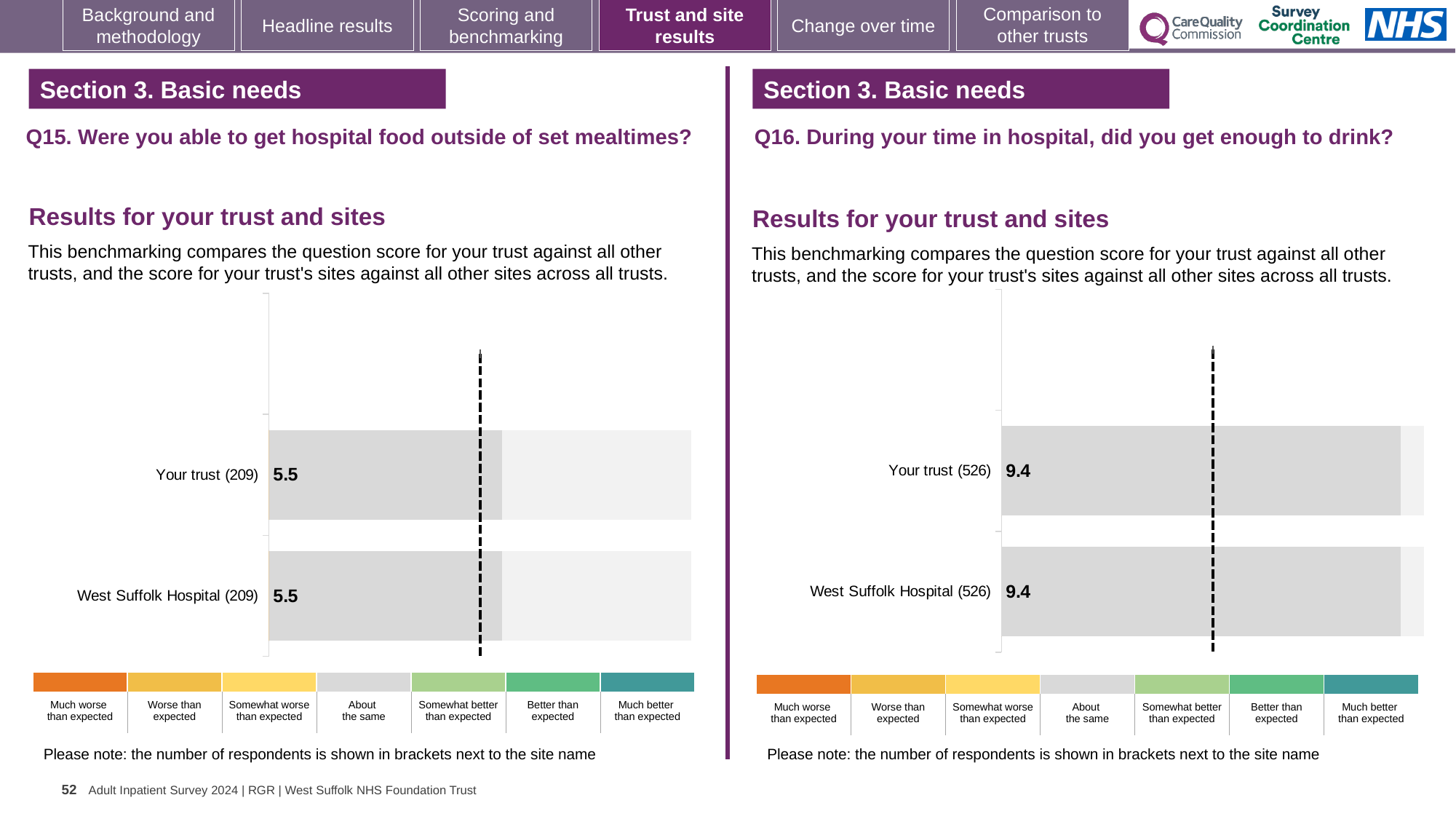
On the Q15 chart (left), what is the score for West Suffolk Hospital? 5.5 On the Q16 chart (right), what is the score for Your trust? 9.4 On the Q15 chart (left), what is the difference between the Your trust score and the West Suffolk Hospital score? 0.0 On the Q16 chart (right), how many bars are plotted? 2 Is the Your trust score on the Q16 chart (right) larger or smaller than the Your trust score on the Q15 chart (left)? Larger On the Q15 chart (left), how many bars are plotted? 2 On the Q16 chart (right), what is the difference between the Your trust score and the West Suffolk Hospital score? 0.0 What kind of chart is used on the Q15 chart (left)? Bar chart On the Q16 chart (right), what is the score for West Suffolk Hospital? 9.4 On the Q15 chart (left), what is the score for Your trust? 5.5 On the Q15 chart (left), how many respondents are shown in brackets for Your trust? 209 On the Q16 chart (right), how many respondents are shown in brackets for West Suffolk Hospital? 526